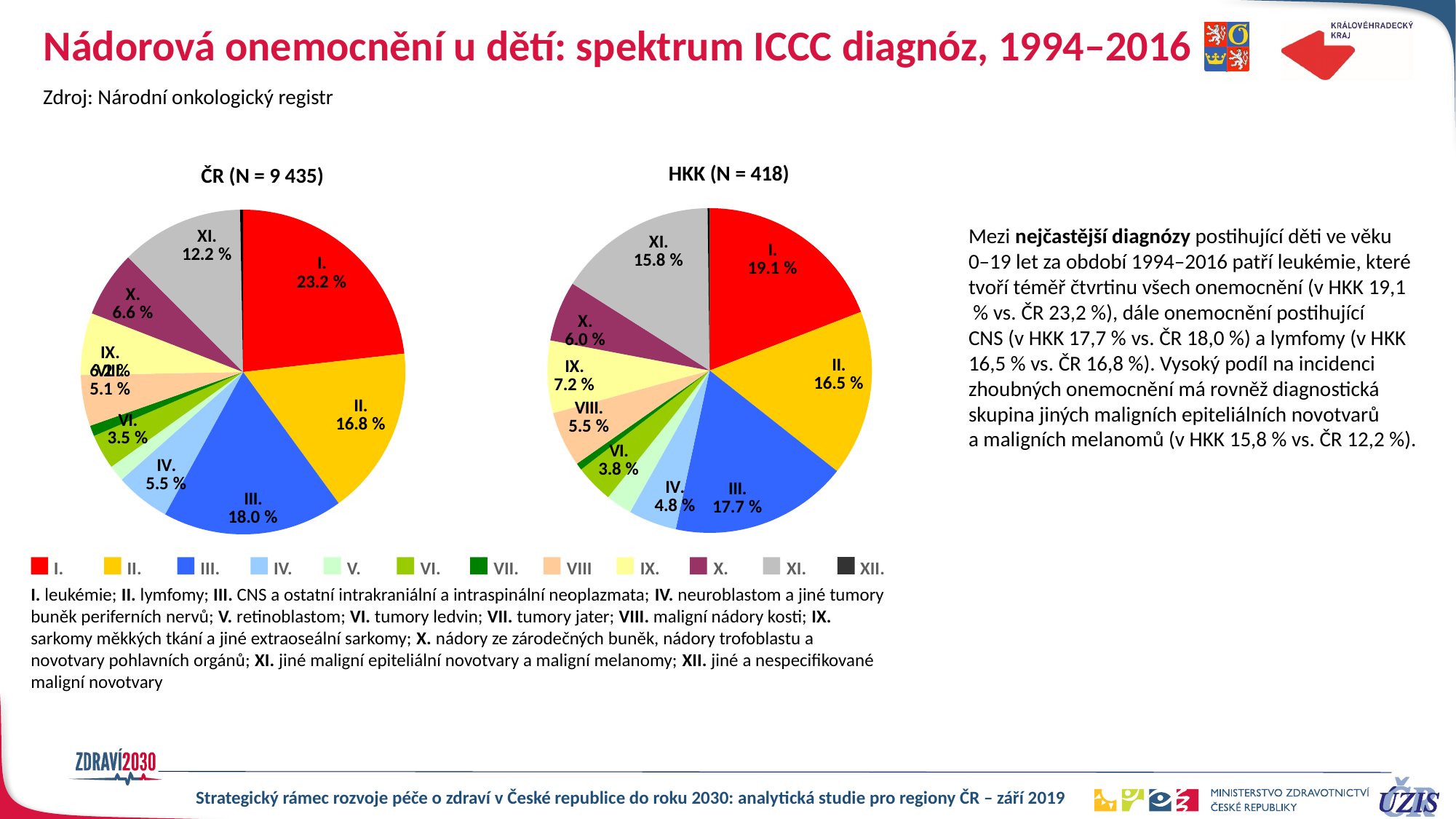
In the HKK (N = 418) pie chart, what share is shown for category XI.? 15.8 % In the ČR (N = 9 435) pie chart, what share is shown for category I.? 23.2 % How many categories does the legend list for the pie charts? 12 In the HKK (N = 418) pie chart, what share is shown for category III.? 17.7 % What is the difference between the share of category I. in the ČR chart and in the HKK chart? 4.1 % In the ČR (N = 9 435) pie chart, which labelled category has the largest share? I. In the HKK (N = 418) pie chart, which is larger: the share of category II. or category III.? III. In the ČR (N = 9 435) pie chart, what share is shown for category X.? 6.6 % What type of chart is used for ČR (N = 9 435) and HKK (N = 418)? Pie chart In the ČR (N = 9 435) pie chart, which is larger: the share of category IV. or category VI.? IV. In the HKK (N = 418) pie chart, which labelled category has the largest share? I. What colour represents category I. in the legend? Red